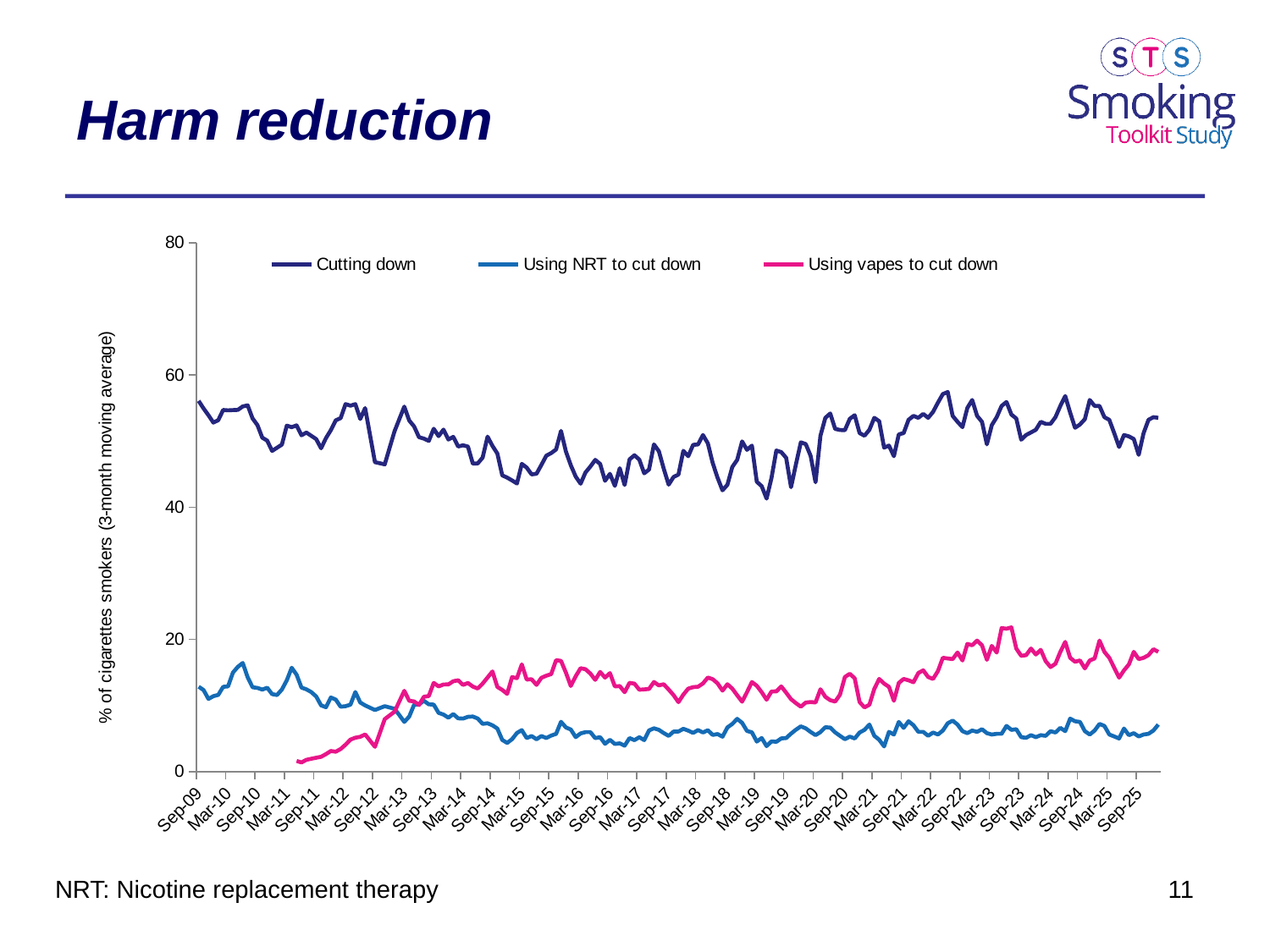
How many series does the legend list? 3 Does the Using vapes to cut down series rise or fall overall from Sep-11 to Sep-25? rise Is the value for Cutting down at Sep-09 greater or less than 40? greater What kind of chart is shown on the slide? line chart Is the value for Cutting down at Sep-19 greater or less than 60? less Is the value for Using NRT to cut down at Sep-25 greater or less than 20? less At Sep-25, which is higher: Using NRT to cut down or Using vapes to cut down? Using vapes to cut down What is the label on the vertical axis? % of cigarettes smokers (3-month moving average) What are the three series named in the legend? Cutting down, Using NRT to cut down, Using vapes to cut down Which series has the highest values across the whole period? Cutting down Does the Using NRT to cut down series rise or fall overall from Sep-09 to Sep-25? fall